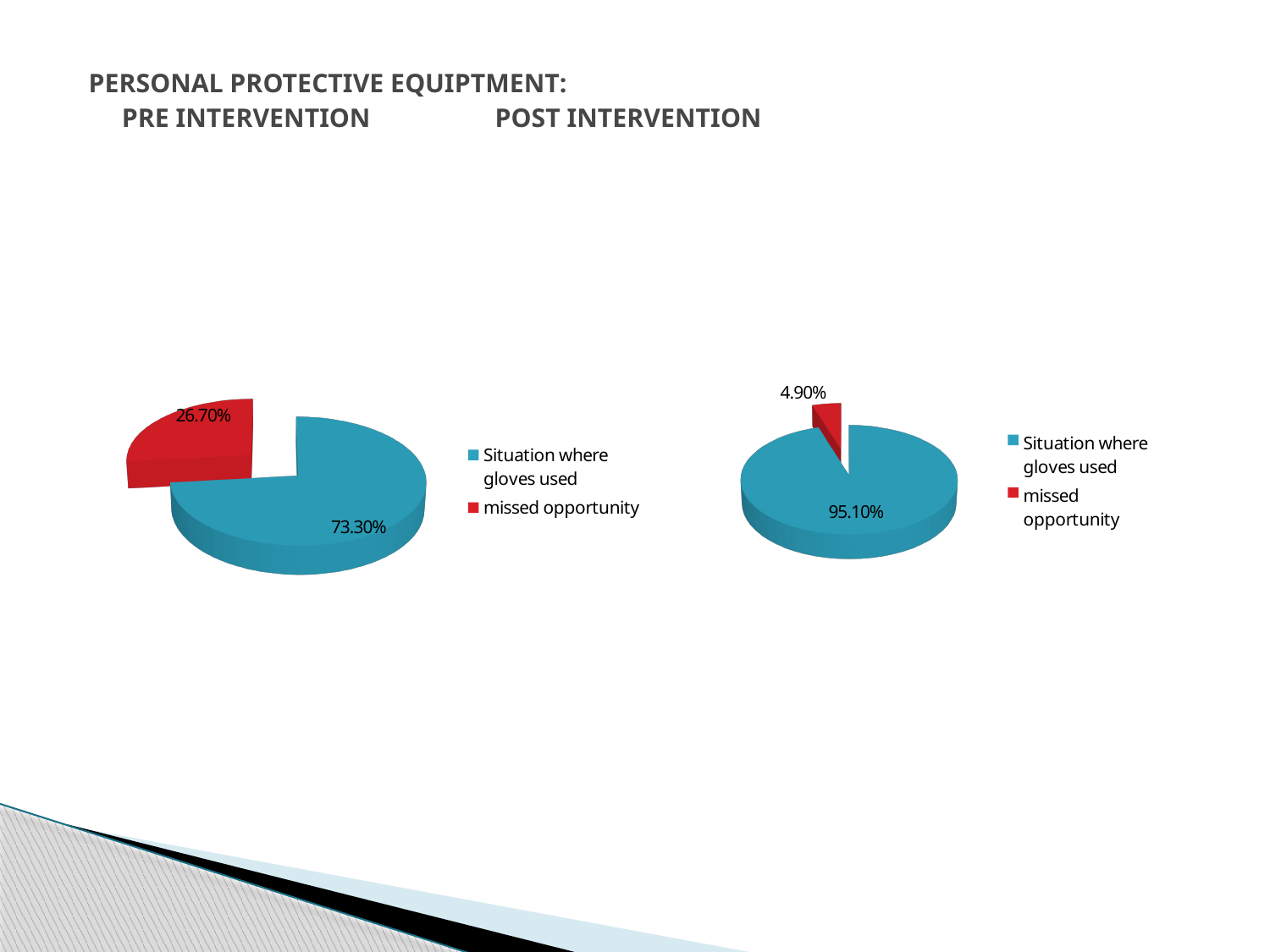
In the pre intervention chart (left), what is the value for 'Situation where gloves used'? 73.30% In the pre intervention chart (left), what is the value for 'missed opportunity'? 26.70% In the pre intervention chart (left), which category has the largest slice? Situation where gloves used In the post intervention chart (right), which category has the smallest slice? missed opportunity What kind of chart is the pre intervention chart (left)? pie chart How many slices does the post intervention chart (right) have? 2 In the post intervention chart (right), what is the value for 'Situation where gloves used'? 95.10% In the post intervention chart (right), what colour is the 'missed opportunity' slice? red How many entries does the legend of the pre intervention chart (left) list? 2 In the post intervention chart (right), what is the value for 'missed opportunity'? 4.90% In the pre intervention chart (left), what is the difference between 'Situation where gloves used' and 'missed opportunity'? 46.60% Is the 'missed opportunity' value larger in the pre intervention chart (left) or the post intervention chart (right)? pre intervention